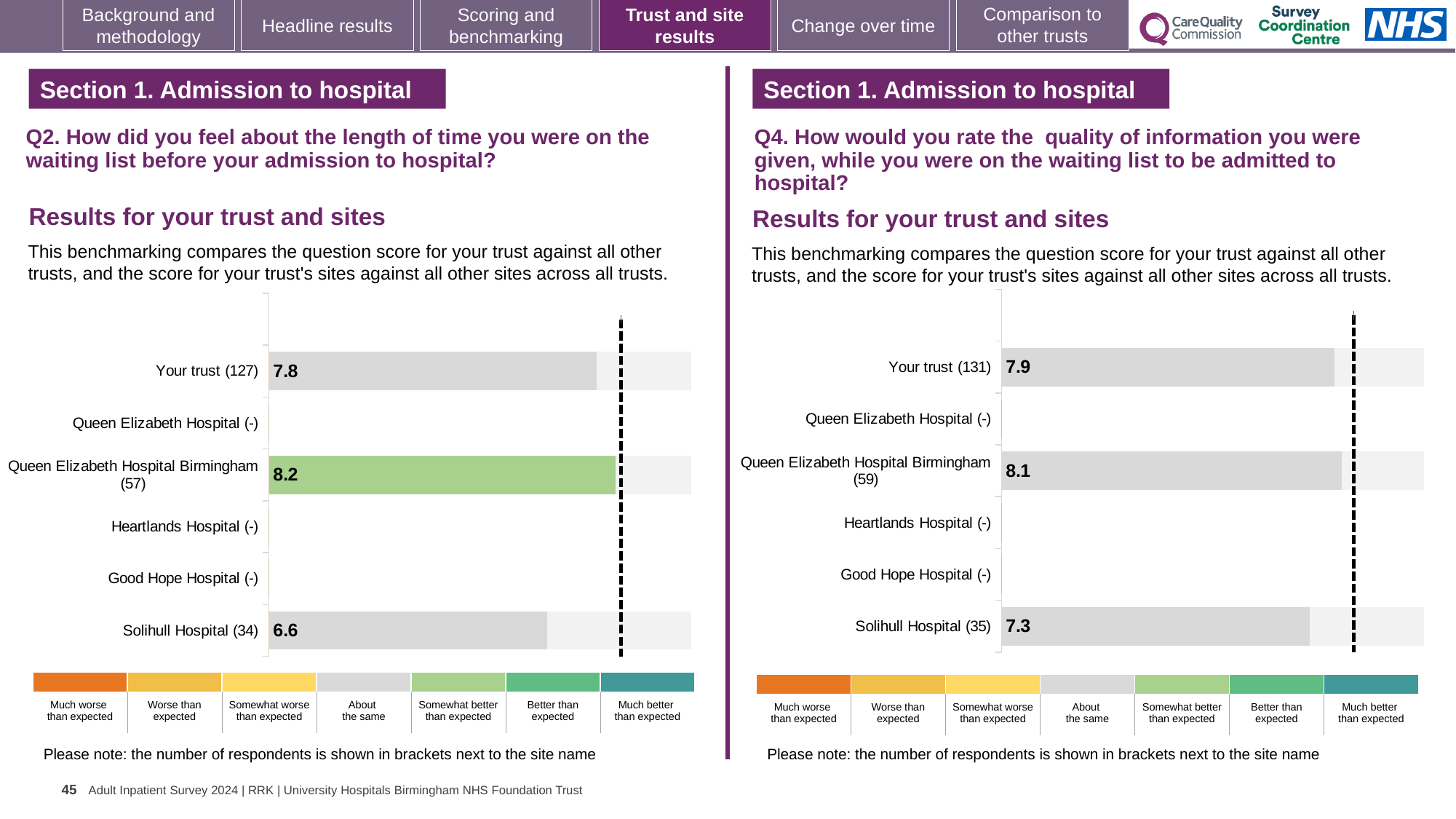
On the Q4 chart (right), what is the difference between the Your trust score and the Solihull Hospital score? 0.6 On the Q2 chart (left), how many respondents are shown in brackets for Solihull Hospital? 34 On the Q4 chart (right), what is the score for Queen Elizabeth Hospital Birmingham? 8.1 On the Q4 chart (right), what is the score for Your trust? 7.9 On the Q2 chart (left), what is the score for Your trust? 7.8 On the Q2 chart (left), what is the score for Queen Elizabeth Hospital Birmingham? 8.2 What type of chart is used on the Q2 chart (left)? Bar chart On the Q2 chart (left), which site with a plotted score has the lowest score? Solihull Hospital On the Q2 chart (left), what is the score for Solihull Hospital? 6.6 On the Q4 chart (right), which has the higher score, Your trust or Solihull Hospital? Your trust On the Q4 chart (right), what is the score for Solihull Hospital? 7.3 On the Q2 chart (left), what is the difference between the Queen Elizabeth Hospital Birmingham score and the Solihull Hospital score? 1.6